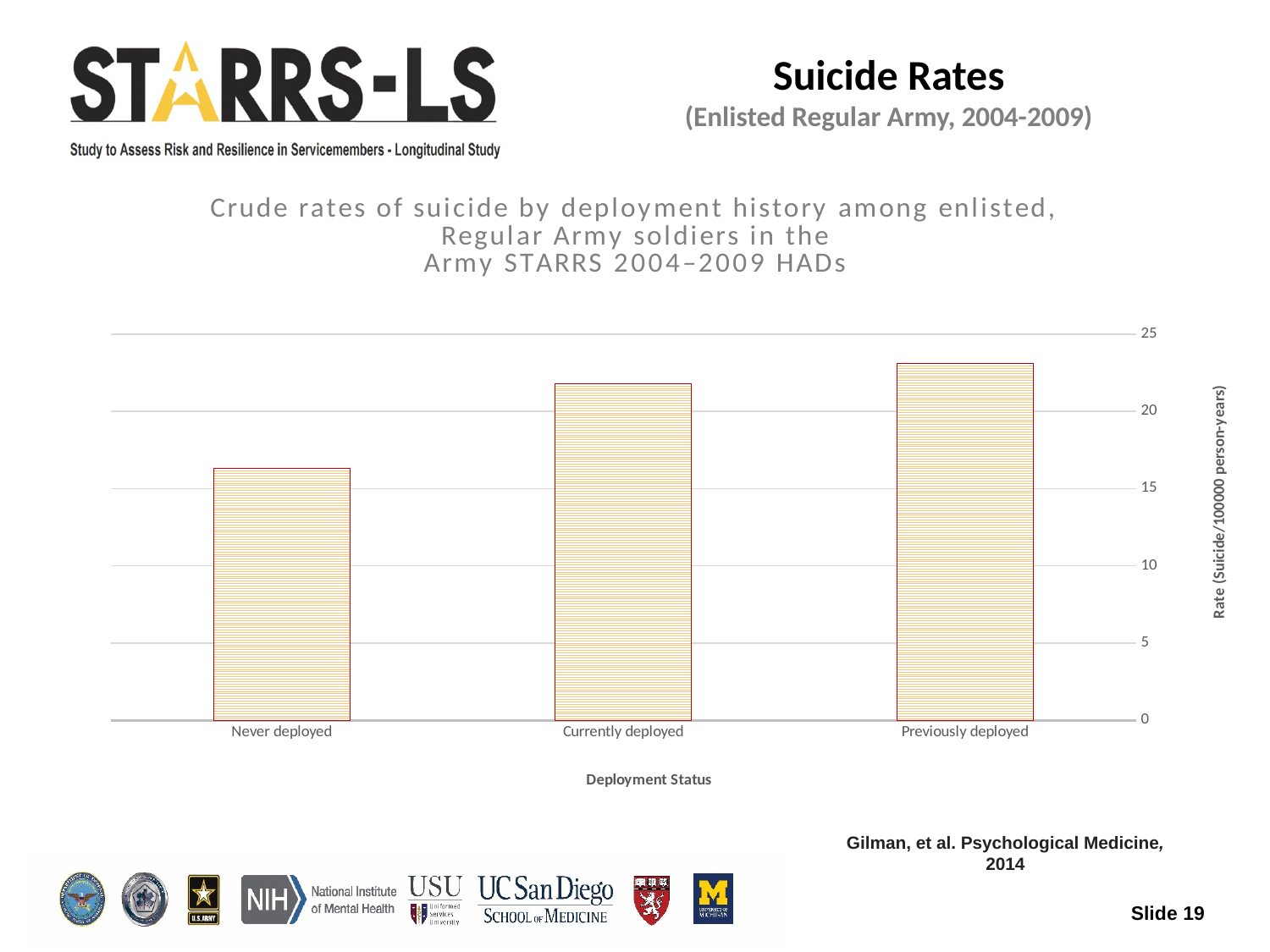
Is the suicide rate for Never deployed greater or less than 15? greater What kind of chart is shown on the slide? bar chart What is the label of the vertical axis of the chart? Rate (Suicide/10000 person-years) How many deployment status categories are plotted in the chart? 3 Is the suicide rate for Previously deployed greater or less than 25? less Which deployment status has the highest suicide rate in the chart? Previously deployed Which deployment status has the lowest suicide rate in the chart? Never deployed Is the suicide rate for Never deployed greater or less than 20? less Which has a higher suicide rate, Never deployed or Currently deployed? Currently deployed Do the suicide rates rise or fall moving from Never deployed to Previously deployed along the x axis? rise What is the label of the horizontal axis of the chart? Deployment Status